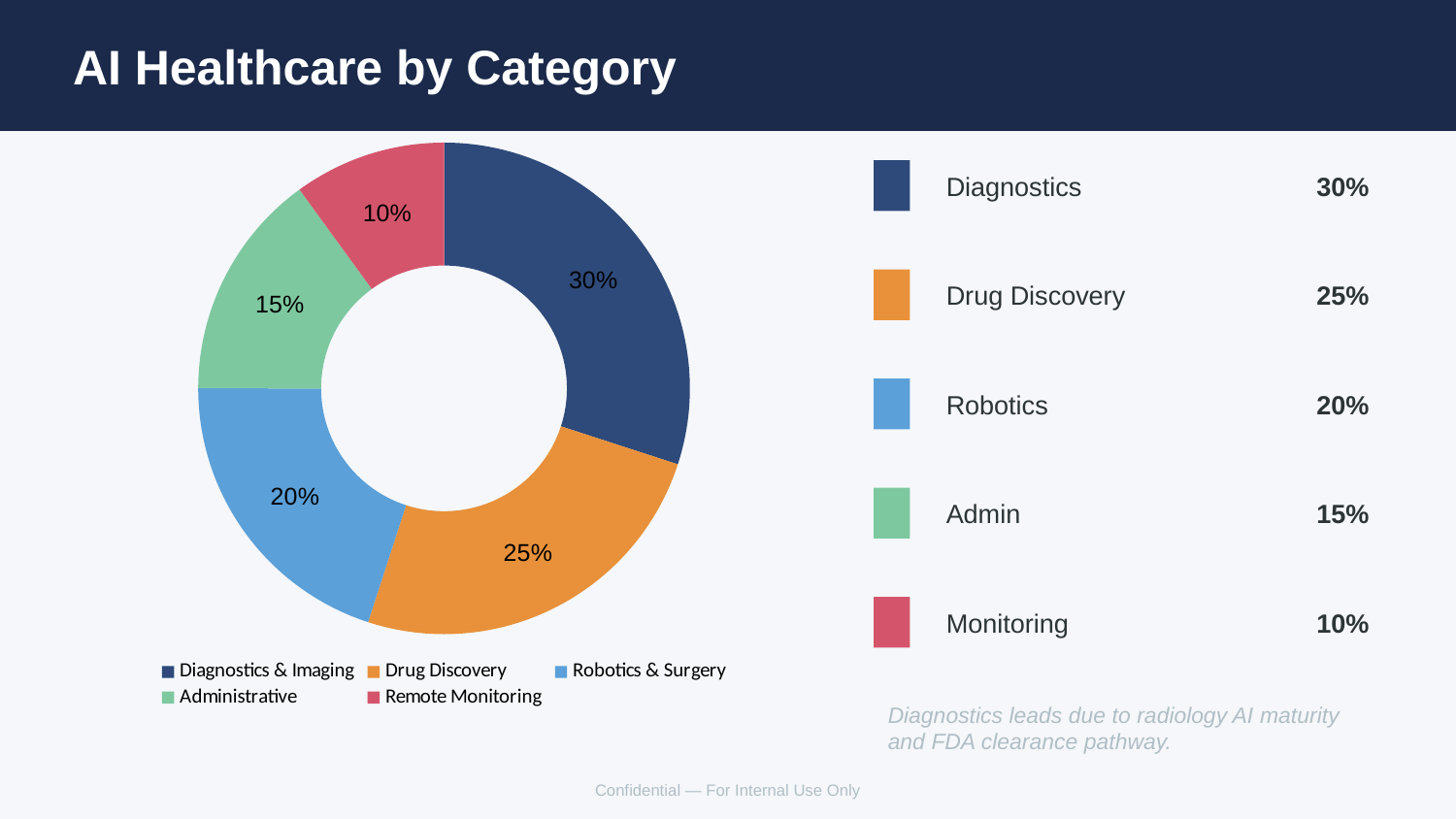
How many categories are shown in the chart? 5 What is the value for Robotics & Surgery? 20% What is the value for Drug Discovery? 25% What kind of chart is shown on the slide? Pie chart (donut) What is the difference between the Diagnostics & Imaging and Remote Monitoring shares? 20% What is the value for Administrative? 15% Which category has the smallest slice? Remote Monitoring What is the title of the slide? AI Healthcare by Category What share of the pie does Diagnostics & Imaging hold? 30% What is the value for Remote Monitoring? 10% Which is larger, Drug Discovery or Administrative? Drug Discovery Which category has the largest slice? Diagnostics & Imaging